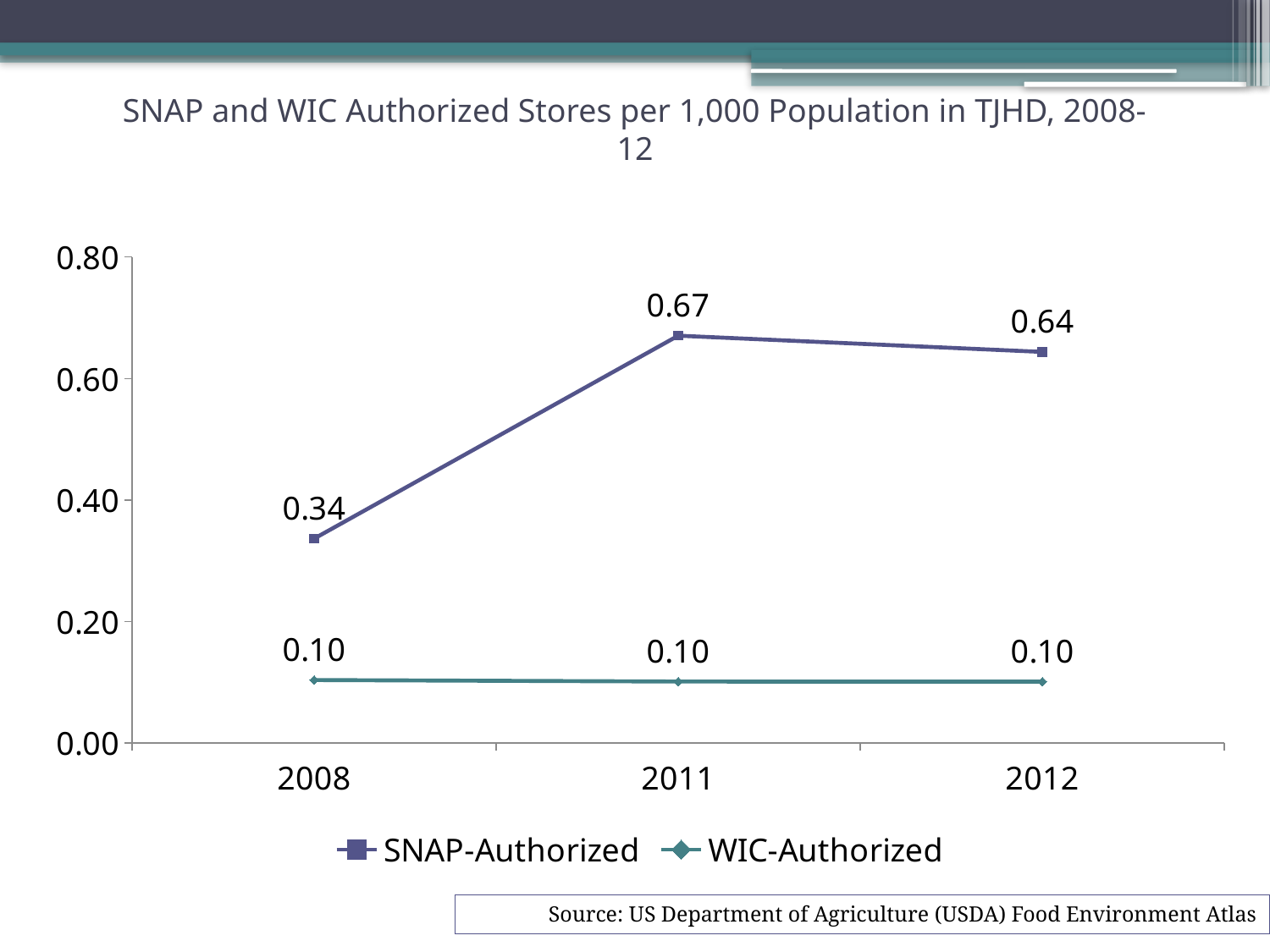
How many series does the legend list? 2 Does the WIC-Authorized value rise, fall, or stay the same from 2008 to 2012? Stays the same What is the difference between the SNAP-Authorized and WIC-Authorized values in 2012? 0.54 How many years are shown on the x axis? 3 What is the value for SNAP-Authorized stores in 2011? 0.67 What is the difference between the SNAP-Authorized values in 2011 and 2008? 0.33 Which series has the larger value in 2008, SNAP-Authorized or WIC-Authorized? SNAP-Authorized What is the value for SNAP-Authorized stores in 2008? 0.34 What kind of chart is shown on the slide? Line chart What is the value for WIC-Authorized stores in 2012? 0.10 In which year is the SNAP-Authorized value lowest? 2008 In which year is the SNAP-Authorized value highest? 2011